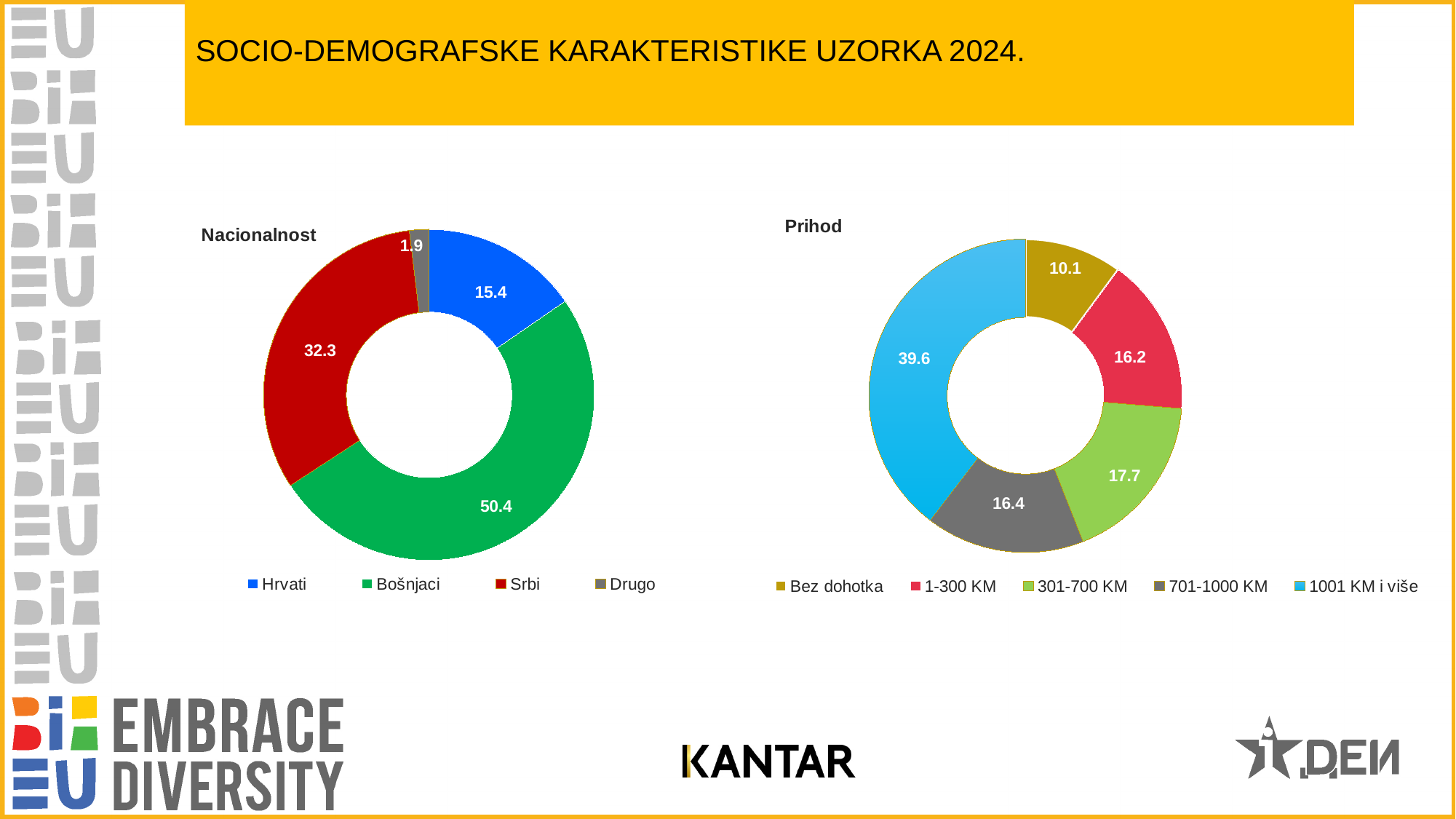
In the Prihod chart, how many categories does the legend list? 5 In the Nacionalnost chart, what is the value for Srbi? 32.3 In the Nacionalnost chart, how many categories are shown? 4 In the Nacionalnost chart, which category has the smallest value? Drugo In the Nacionalnost chart, what is the value for Bošnjaci? 50.4 In the Prihod chart, what is the difference between the values for 1001 KM i više and Bez dohotka? 29.5 In the Prihod chart, which category has the highest value? 1001 KM i više In the Prihod chart, which category has the lowest value? Bez dohotka In the Prihod chart, what is the value for 301-700 KM? 17.7 In the Nacionalnost chart, what is the difference between the values for Bošnjaci and Srbi? 18.1 What type of chart is the Prihod chart? Doughnut chart In the Prihod chart, what is the value for 1001 KM i više? 39.6